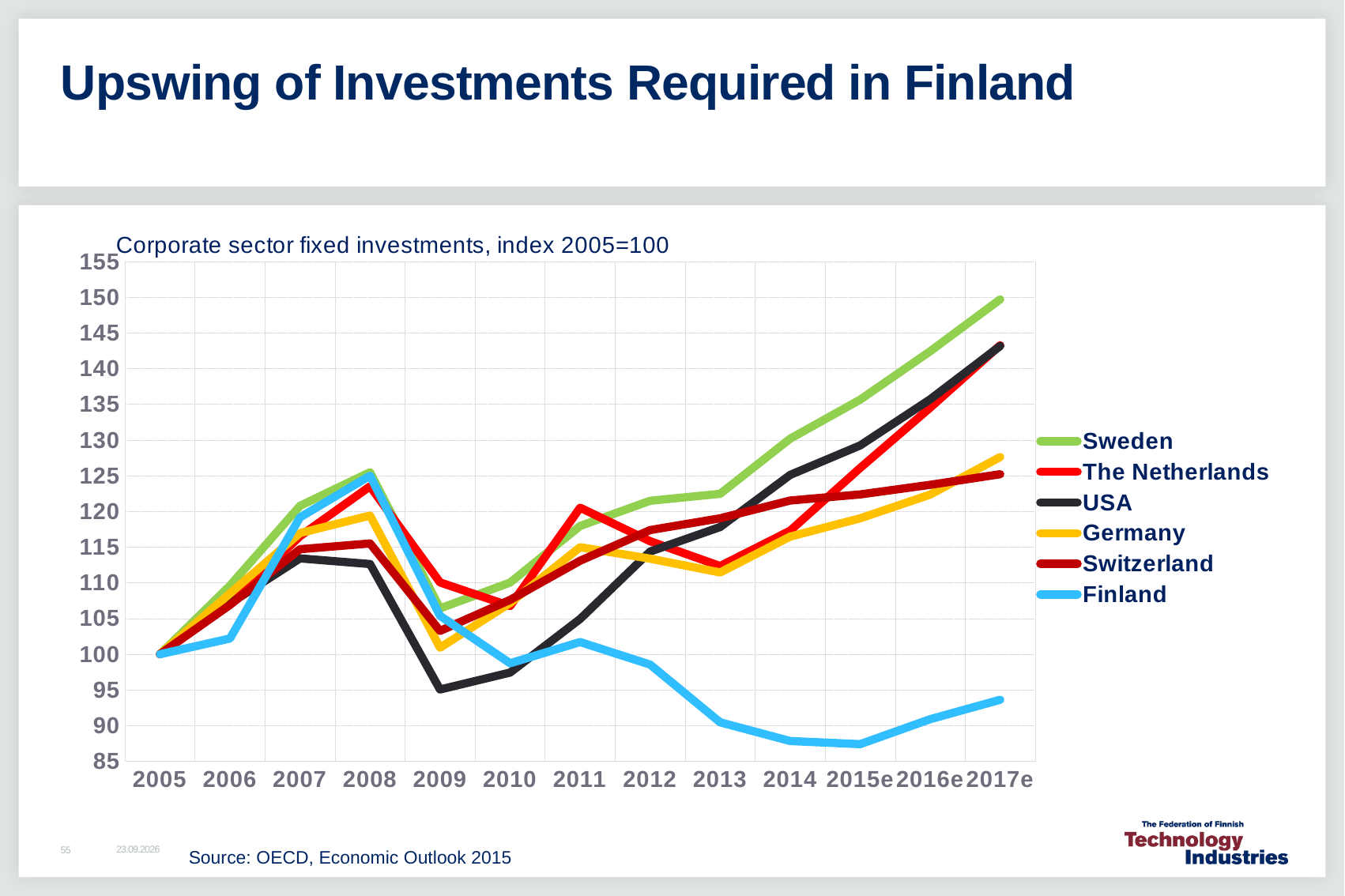
What is the index value for Finland in 2005? 100 How many years are shown along the x axis? 13 Does the Finland line rise or fall from 2011 to 2015e? fall Which is larger in 2017e, the value for Sweden or the value for Finland? Sweden What kind of chart is shown on the slide? line chart Is the value for Sweden in 2017e greater or less than 145? greater What is the source cited for the chart? OECD, Economic Outlook 2015 Is the value for Finland in 2017e greater or less than 95? less How many series does the legend list? 6 Which country has the highest index value in 2017e? Sweden Which country has the lowest index value in 2017e? Finland Is the value for Finland in 2015e greater or less than 90? less